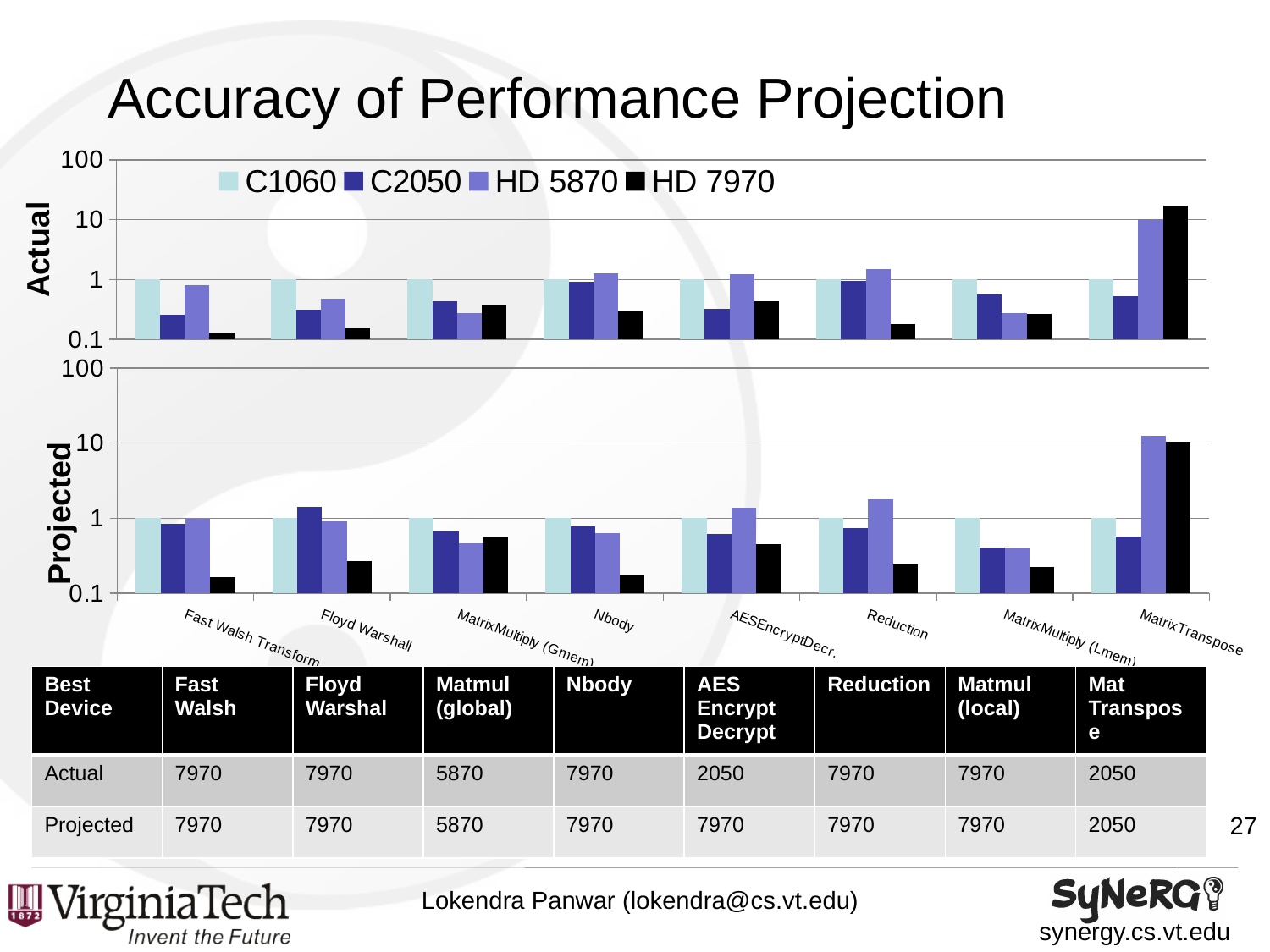
How many categories are shown along the x axis of the bottom chart labelled "Projected"? 8 In the bottom chart labelled "Projected", which category has the highest HD 5870 bar? MatrixTranspose In the bottom chart labelled "Projected", for MatrixTranspose, which is larger: HD 5870 or HD 7970? HD 5870 What are the four series listed in the legend? C1060, C2050, HD 5870, HD 7970 In the top chart labelled "Actual", for MatrixTranspose, which is larger: HD 7970 or HD 5870? HD 7970 In the top chart labelled "Actual", is the HD 7970 value for Fast Walsh Transform greater or less than 1? less In the top chart labelled "Actual", is the HD 7970 value for MatrixTranspose greater or less than 10? greater In the top chart labelled "Actual", which category has the highest HD 7970 bar? MatrixTranspose In the bottom chart labelled "Projected", is the C2050 value for Floyd Warshall greater or less than 1? greater What kind of chart is the top chart labelled "Actual"? bar chart In the top chart labelled "Actual", which category has the lowest HD 7970 bar? Fast Walsh Transform How many series does the legend list for the charts? 4